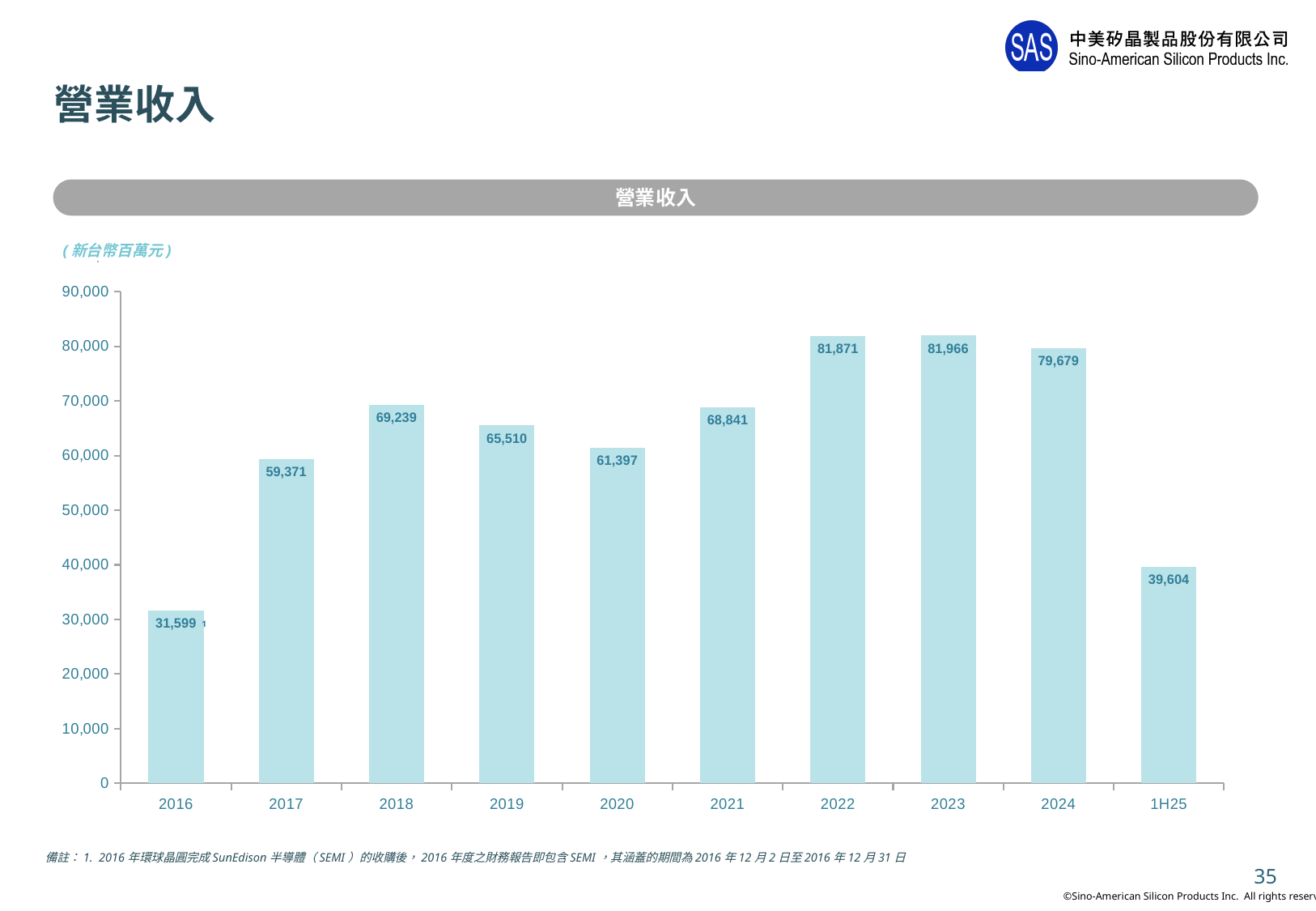
Which period has the lowest revenue? 2016 What is the revenue value shown for 1H25? 39,604 Does revenue rise or fall from 2018 to 2020? fall Which is larger, the revenue for 2018 or for 2019? 2018 How many periods are shown on the x axis? 10 Is the revenue for 2024 greater or less than 70,000? greater What is the difference between the revenue for 2018 and 2017? 9,868 What kind of chart is shown on the slide? bar chart What is the revenue value shown for 2019? 65,510 What is the difference between the revenue for 2022 and 2021? 13,030 Which period has the highest revenue according to the data labels? 2023 What is the revenue value shown for 2022? 81,871